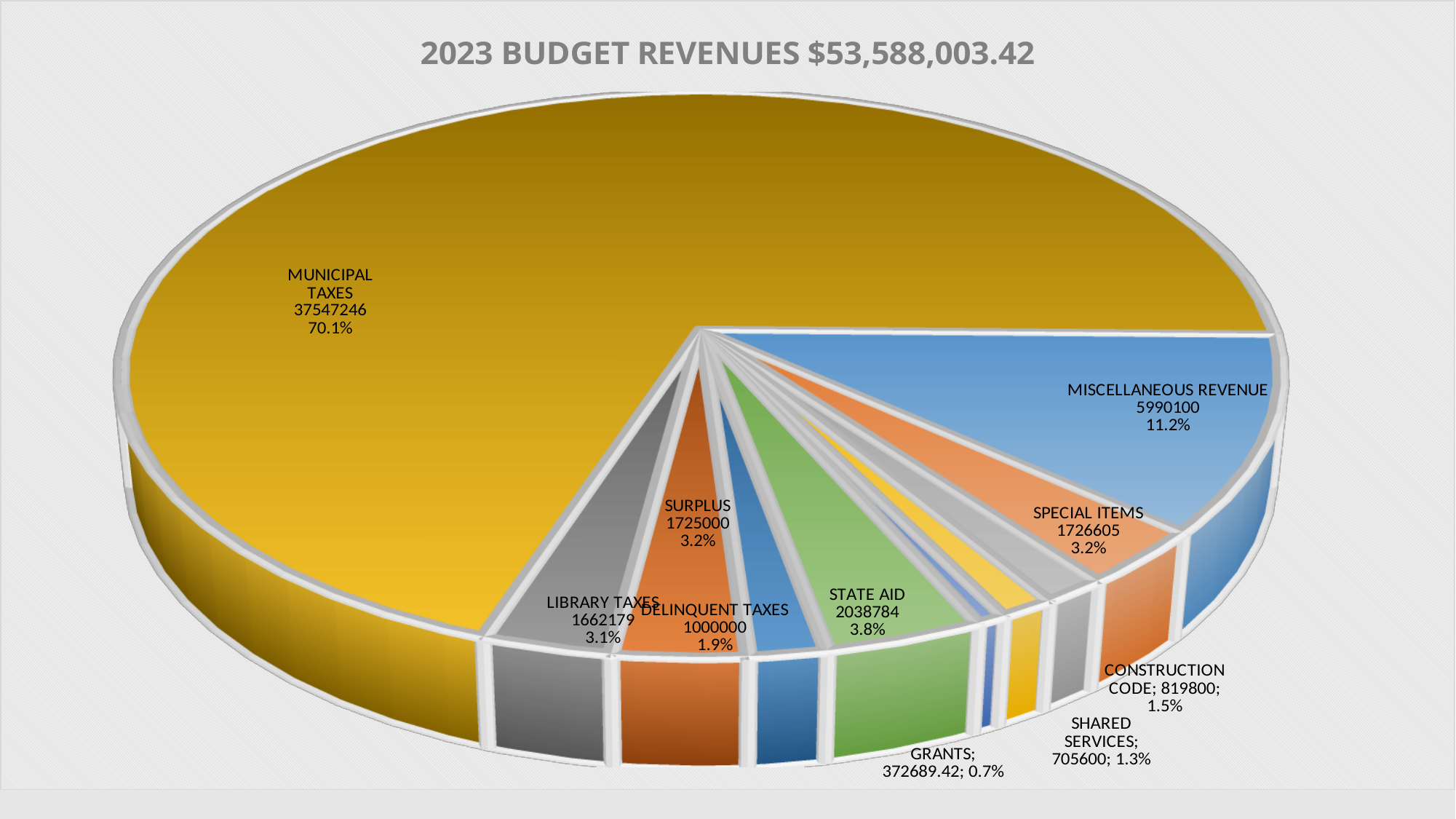
What type of chart is shown on the slide? pie chart How many slices does the pie chart have? 10 What percentage share of the pie is MISCELLANEOUS REVENUE? 11.2% Which category has the largest slice of the pie? MUNICIPAL TAXES What value is shown for STATE AID? 2038784 Which category has the smallest slice of the pie? GRANTS What value is shown for GRANTS? 372689.42 What percentage share of the pie is DELINQUENT TAXES? 1.9% What is the difference between the values for SURPLUS and LIBRARY TAXES? 62821 What value is shown for MUNICIPAL TAXES? 37547246 What is the title of the chart? 2023 BUDGET REVENUES $53,588,003.42 Which is larger, the value for CONSTRUCTION CODE or SHARED SERVICES? CONSTRUCTION CODE